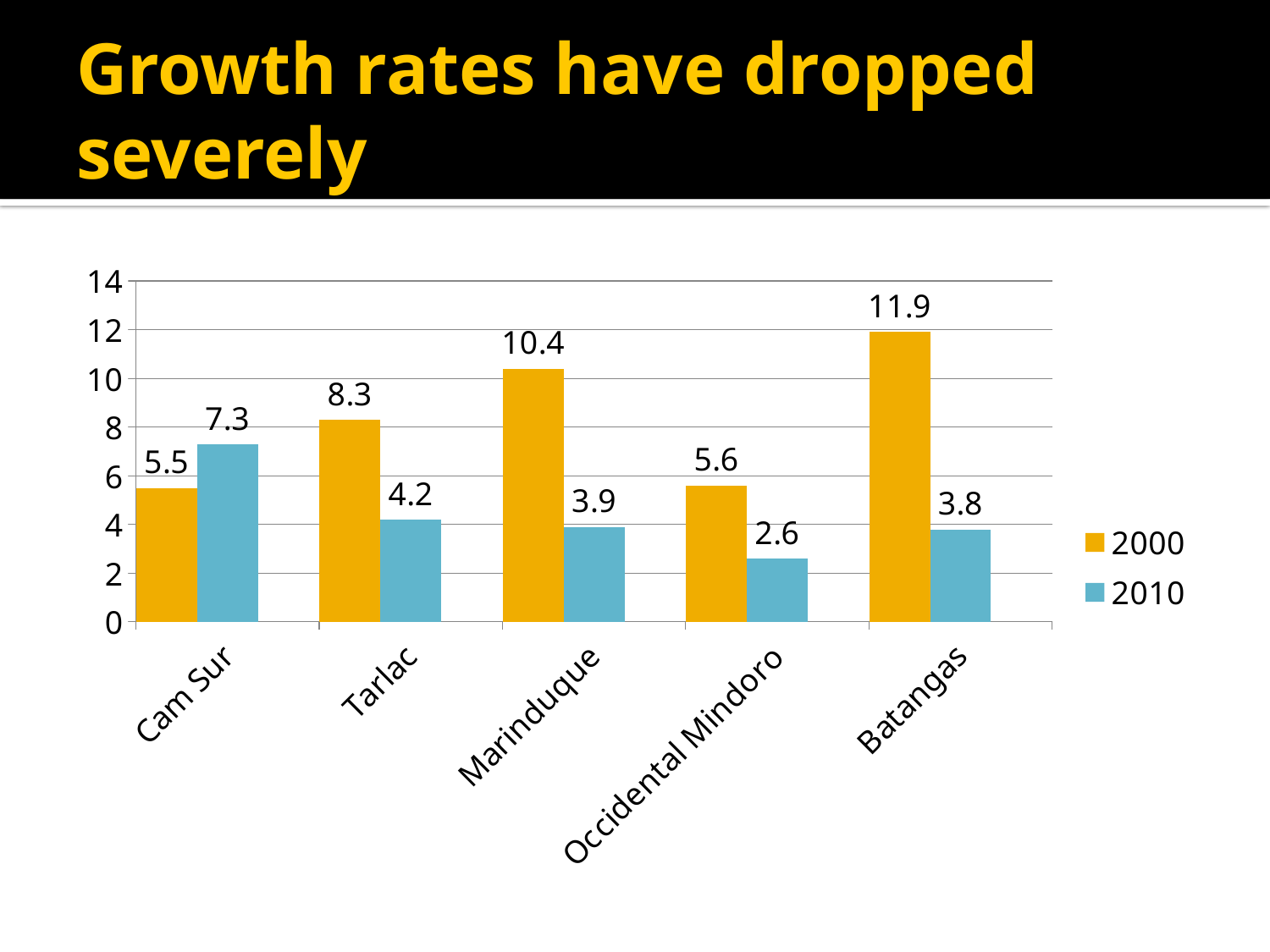
What is the 2000 value for Batangas? 11.9 What colour represents the 2010 series in the legend? blue Which category has the lowest 2010 value? Occidental Mindoro What is the difference between the 2000 and 2010 values for Marinduque? 6.5 Is the 2000 value for Tarlac greater or less than 8? greater What is the 2010 value for Cam Sur? 7.3 Which category has the highest 2000 value? Batangas What is the 2010 value for Occidental Mindoro? 2.6 How many series does the legend list? 2 How many categories are shown on the x axis? 5 Which is larger for Cam Sur, the 2000 value or the 2010 value? 2010 What kind of chart is shown on the slide? bar chart